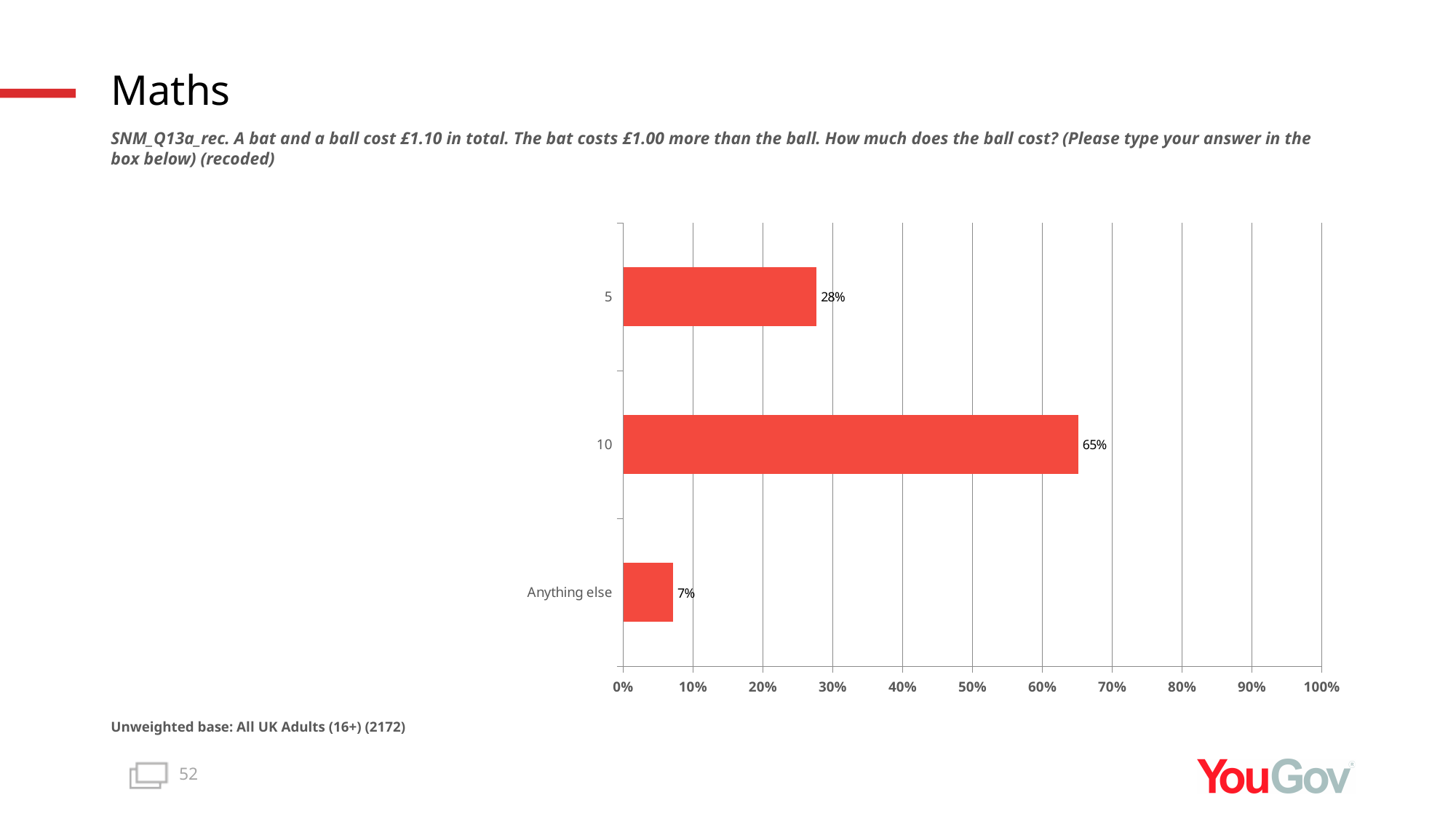
What kind of chart is shown on the slide? Bar chart What percentage of respondents answered "Anything else"? 7% What is the difference in percentage points between the "10" and "5" categories? 37 Which category has the lowest percentage? Anything else What is the difference in percentage points between the "5" and "Anything else" categories? 21 How many categories are shown in the chart? 3 Which is larger, the value for "5" or the value for "Anything else"? 5 What is the unweighted base stated below the chart? All UK Adults (16+) (2172) Which category has the highest percentage? 10 Is the value for "10" greater or less than 50%? greater What percentage of respondents answered "5"? 28% What percentage of respondents answered "10"? 65%